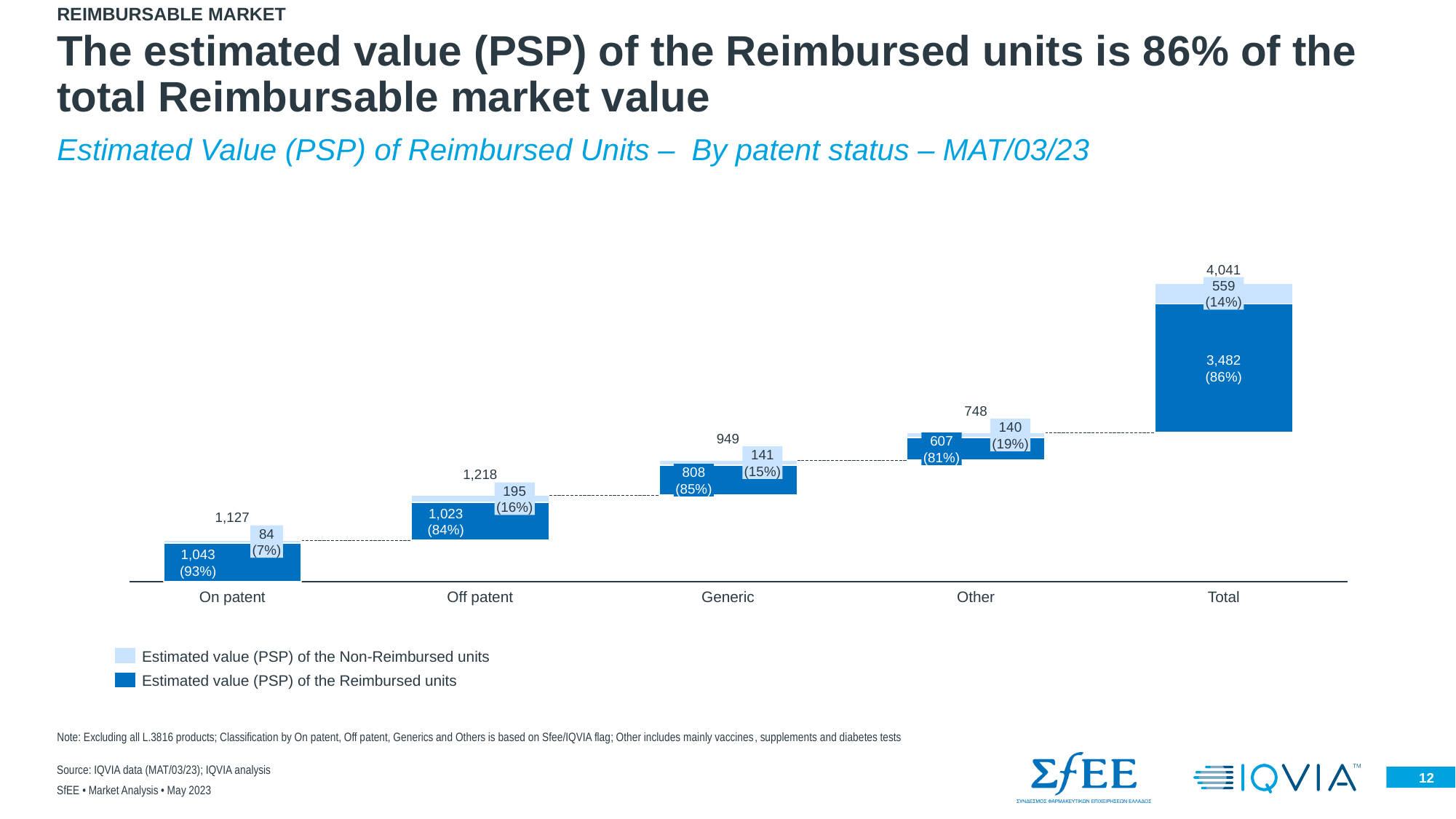
What is the total value shown for the Total bar? 4,041 How many series does the legend list? 2 What percentage share of the Other category is made up of Reimbursed units? 81% Which patent status category (excluding Total) has the lowest total value? Other What is the difference between the Reimbursed units value for Off patent and for Generic? 215 Which patent status category (excluding Total) has the highest total value? Off patent Which is larger, the Non-Reimbursed units value for Generic or for Other? Generic How many categories are shown on the x axis? 5 What is the estimated value (PSP) of the Non-Reimbursed units for Off patent? 195 What is the estimated value (PSP) of the Reimbursed units for On patent? 1,043 What kind of chart is shown on the slide? Stacked bar chart (waterfall) What is the total value shown above the Generic bar? 949